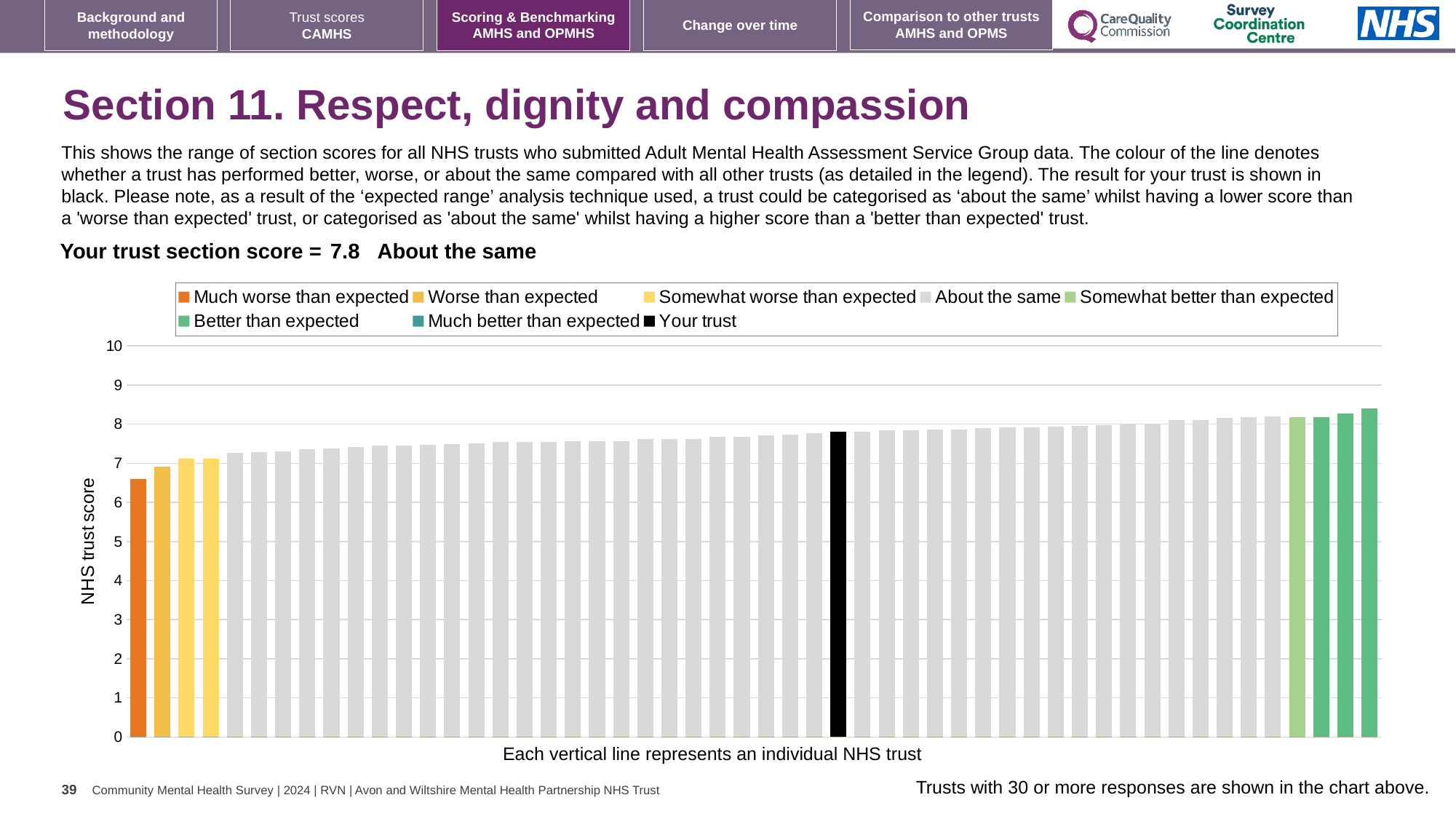
How many entries does the chart legend list? 8 What is the section score for your trust shown on the slide? 7.8 How many bars are coloured as 'Better than expected' (green)? 3 Do the bar values rise or fall from left to right along the x axis? rise What kind of chart is shown on the slide? bar chart Which category does your trust fall into according to the slide? About the same Is the value for your trust (the black bar) greater or less than 8? less Is the value of the lowest bar (the orange 'Much worse than expected' bar) greater or less than 7? less Is the value of the highest bar on the right greater or less than 8? greater What is the label on the vertical axis of the chart? NHS trust score What does each vertical line in the chart represent, according to the caption below the chart? an individual NHS trust How many bars are coloured as 'Much worse than expected' (orange)? 1